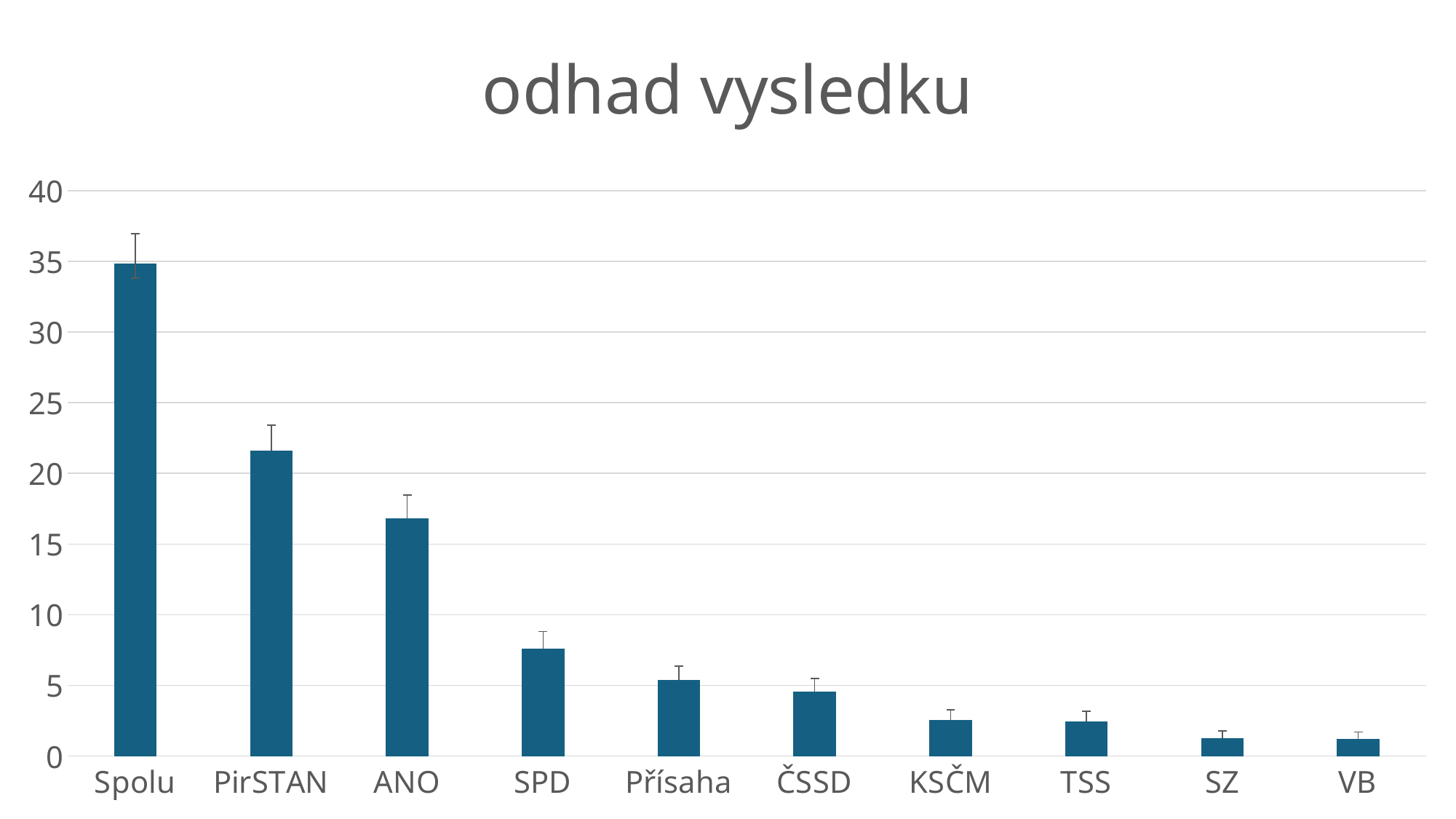
Is the value for SPD greater or less than 10? less Is the value for PirSTAN greater or less than 20? greater How many categories are shown on the x axis? 10 Which is larger, the value for SPD or the value for KSČM? SPD Which category has the highest value? Spolu Is the value for Spolu greater or less than 30? greater What kind of chart is shown on the slide? bar chart Which is larger, the value for PirSTAN or the value for ANO? PirSTAN Do the values rise or fall from left to right along the x axis? fall What is the title of the chart? odhad vysledku